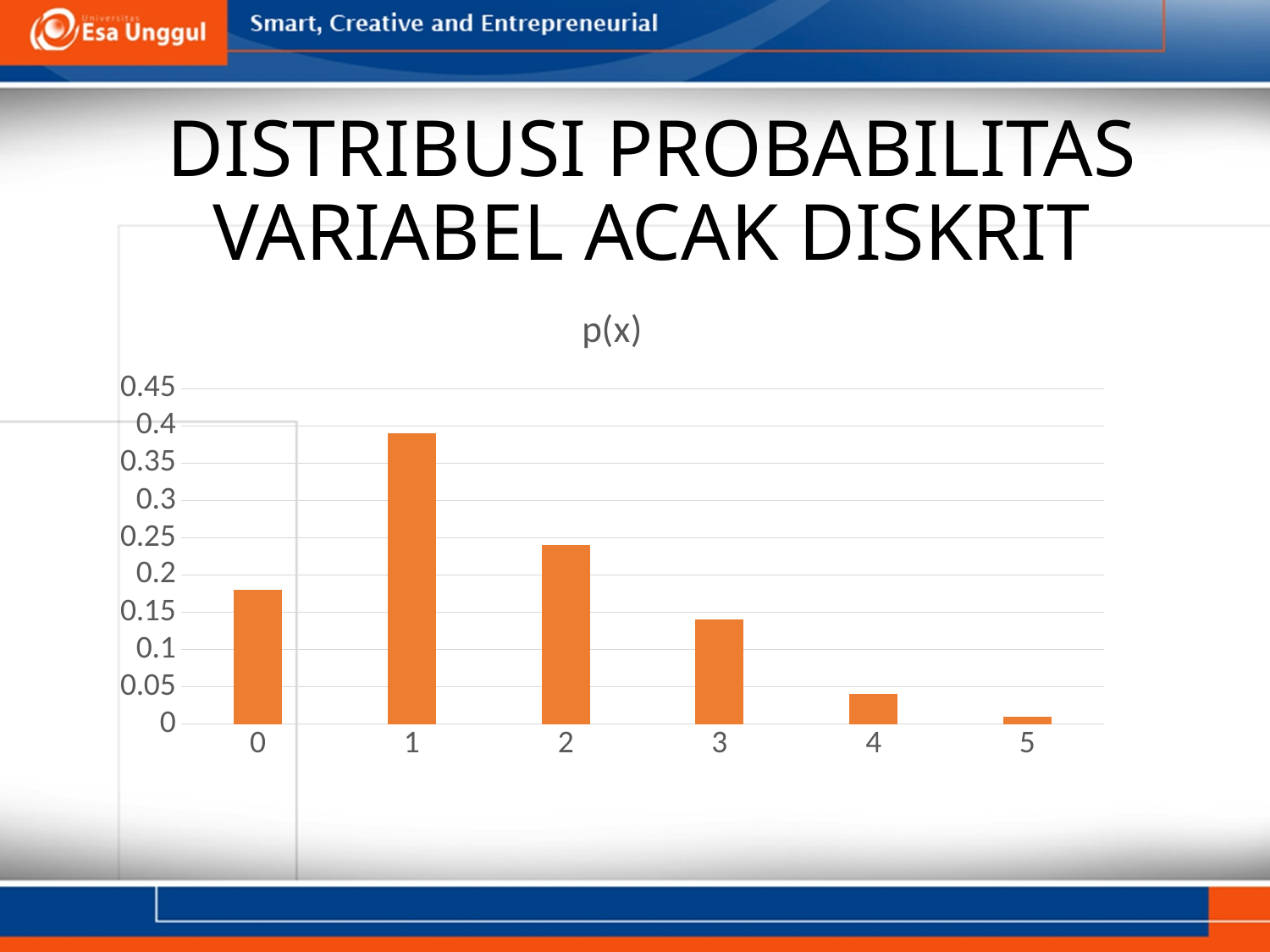
Is the value for category 4 greater or less than 0.1? less How many categories are shown on the x axis of the chart? 6 Is the value for category 1 greater or less than 0.35? greater What kind of chart is shown on the slide? bar chart Which category has the lowest value in the chart? 5 What is the title of the chart? p(x) From category 1 to category 5, do the values rise or fall? fall Is the value for category 0 greater or less than 0.15? greater Which is larger, the value for category 1 or the value for category 2? 1 Which category has the highest value in the chart? 1